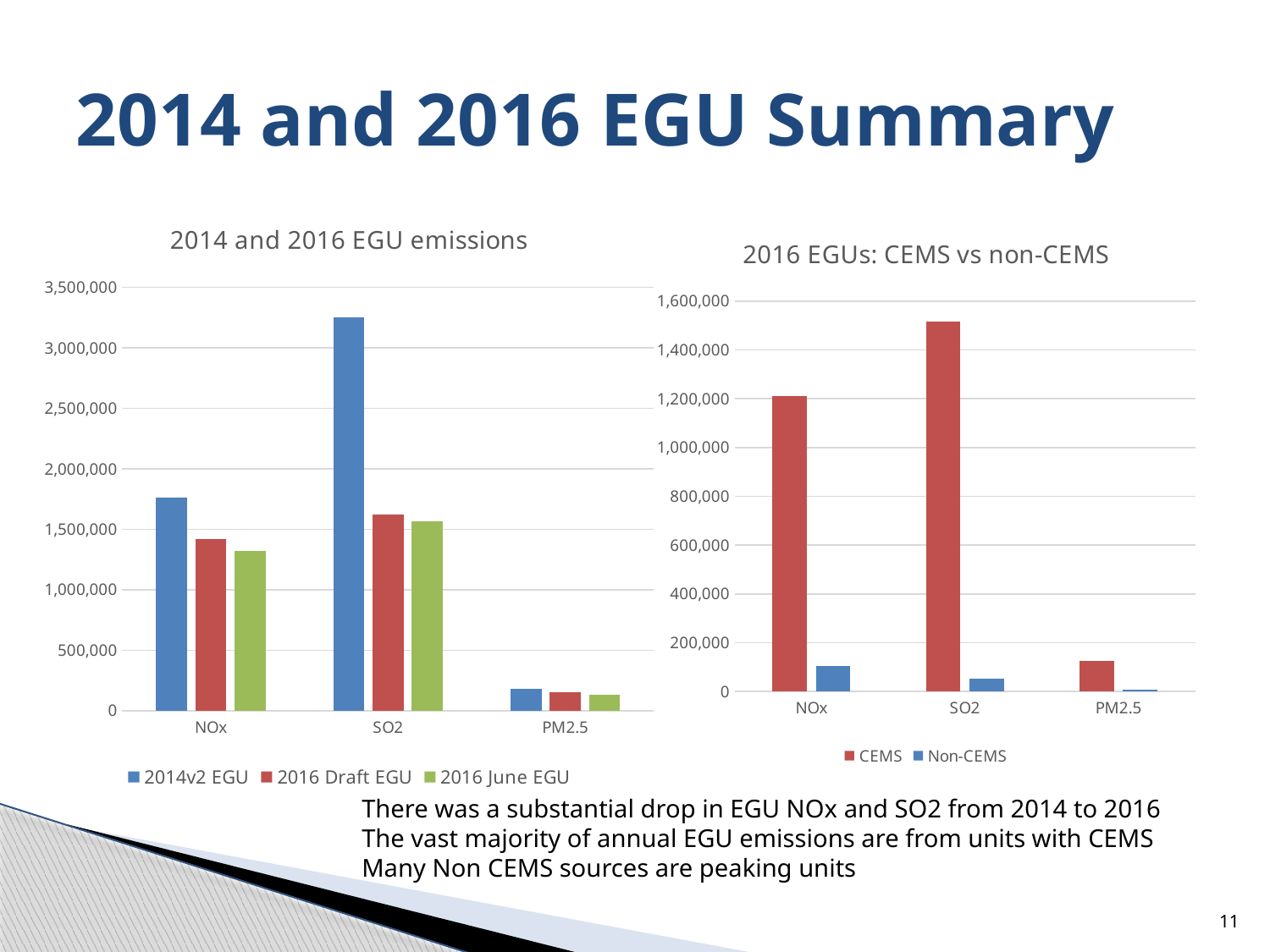
In the '2014 and 2016 EGU emissions' chart, is the 2016 June EGU value for NOx greater or less than 1,500,000? less How many pollutant categories are shown on the x axis of the '2016 EGUs: CEMS vs non-CEMS' chart? 3 What kind of chart is the '2014 and 2016 EGU emissions' chart? Bar chart In the '2014 and 2016 EGU emissions' chart, which pollutant has the lowest values across all three series? PM2.5 In the '2016 EGUs: CEMS vs non-CEMS' chart, which pollutant has the highest CEMS value? SO2 In the '2016 EGUs: CEMS vs non-CEMS' chart, is the CEMS value for NOx greater or less than 1,000,000? greater How many series does the legend of the '2014 and 2016 EGU emissions' chart list? 3 In the '2014 and 2016 EGU emissions' chart, is the 2014v2 EGU value for SO2 greater or less than 3,000,000? greater In the '2014 and 2016 EGU emissions' chart, which is larger for NOx: the 2014v2 EGU value or the 2016 Draft EGU value? 2014v2 EGU In the '2016 EGUs: CEMS vs non-CEMS' chart, which colour represents the Non-CEMS series? Blue In the '2014 and 2016 EGU emissions' chart, which pollutant has the highest 2014v2 EGU value? SO2